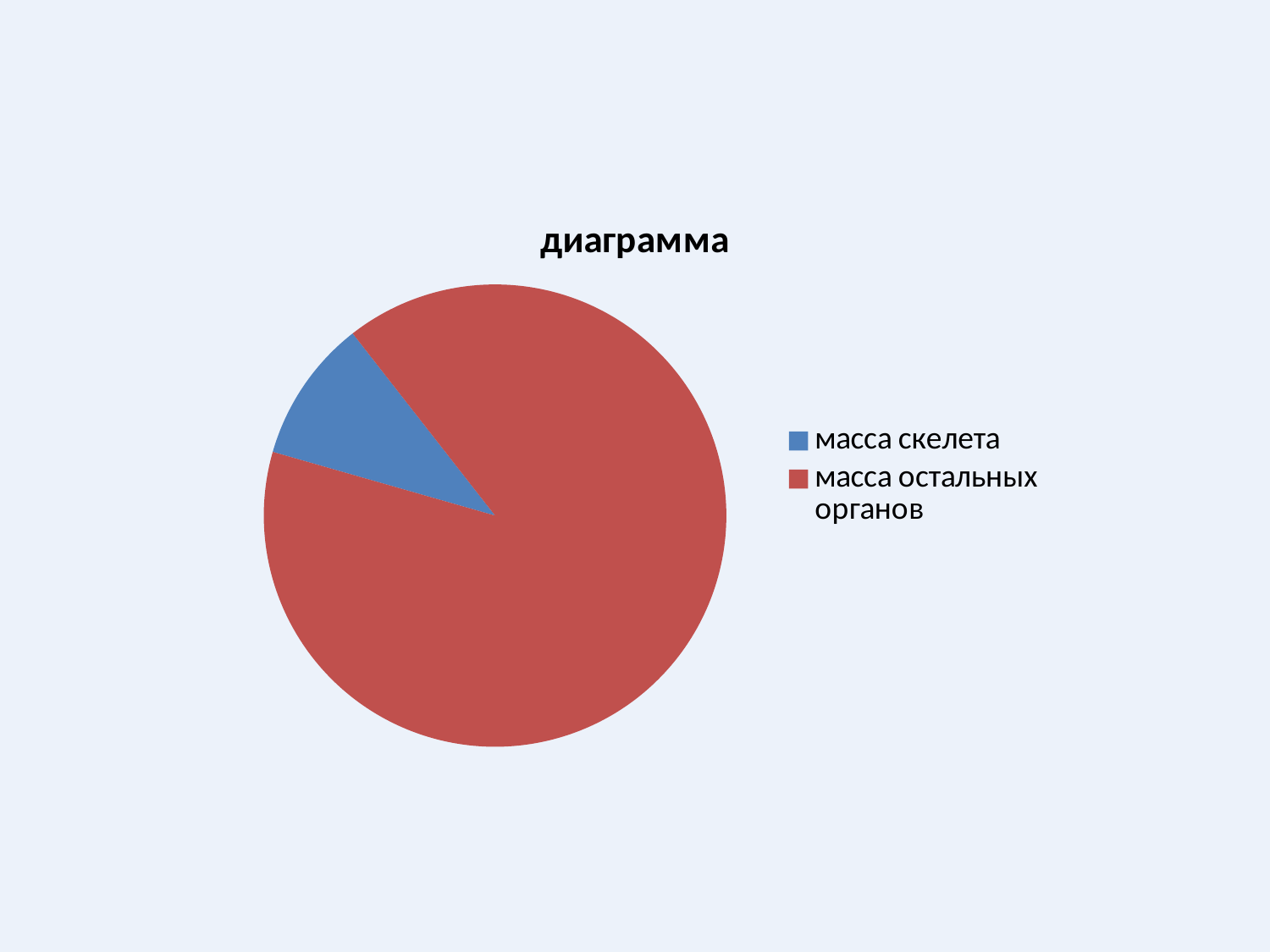
Which is larger: the slice for масса скелета or the slice for масса остальных органов? масса остальных органов How many slices does the pie chart have? 2 What is the title of the chart? диаграмма Which category has the largest slice of the pie? масса остальных органов Which category has the smallest slice of the pie? масса скелета What kind of chart is shown on the slide? pie chart What colour is the slice for масса скелета? blue How many entries does the legend list? 2